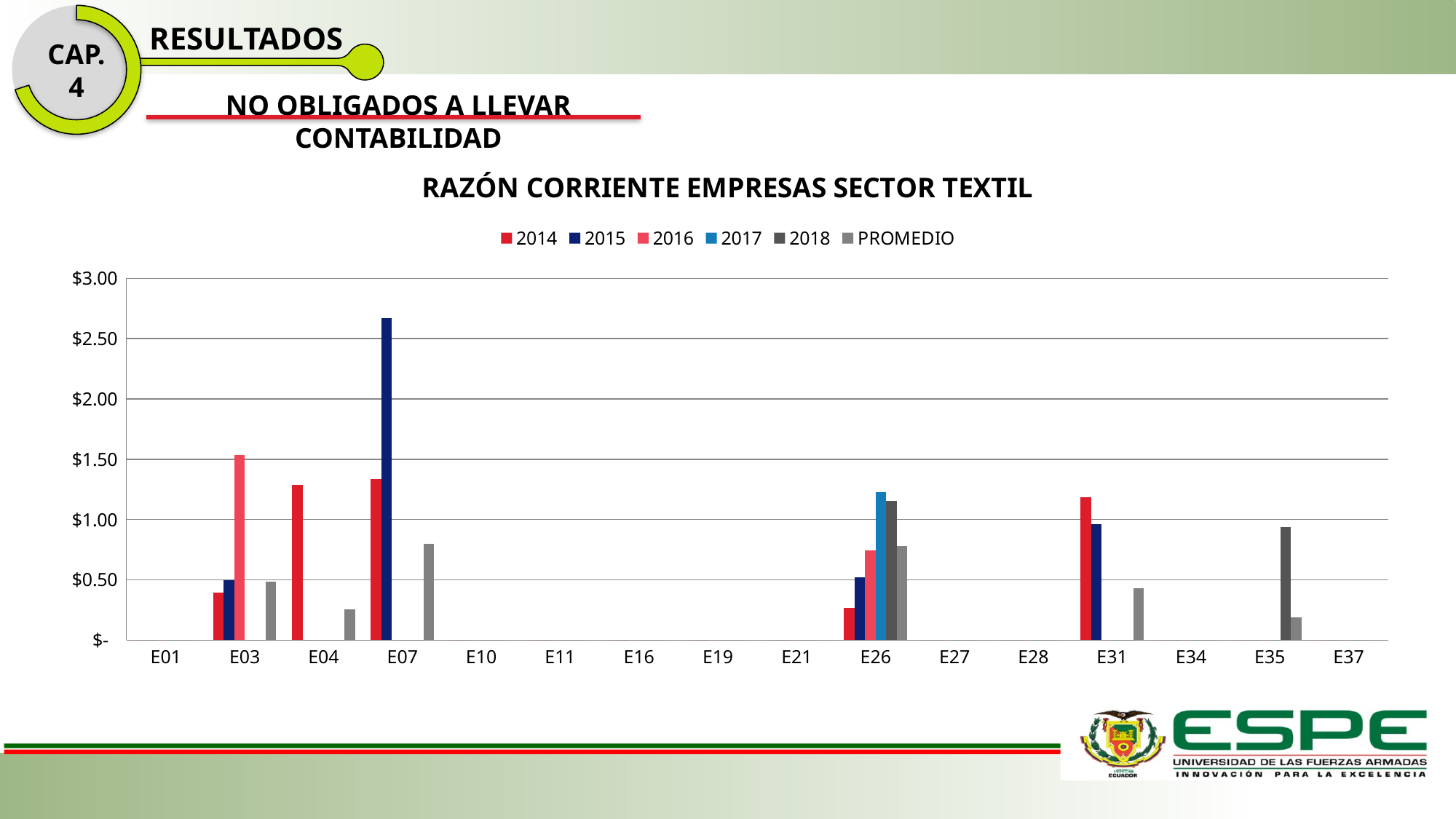
Which series is shown in light blue in the legend? 2017 Is the 2014 value for E03 greater or less than $0.50? less Which is larger: the PROMEDIO value for E26 or the PROMEDIO value for E31? the PROMEDIO value for E26 What type of chart is shown on the slide? bar chart What is the title of the chart? RAZÓN CORRIENTE EMPRESAS SECTOR TEXTIL How many categories are shown on the x axis? 16 Is the 2015 value for E07 greater or less than $2.50? greater Which category has the tallest bar in the chart? E07 Is the 2018 value for E35 greater or less than $1.00? less How many series does the legend list? 6 Which is larger: the 2015 value for E07 or the 2016 value for E03? the 2015 value for E07